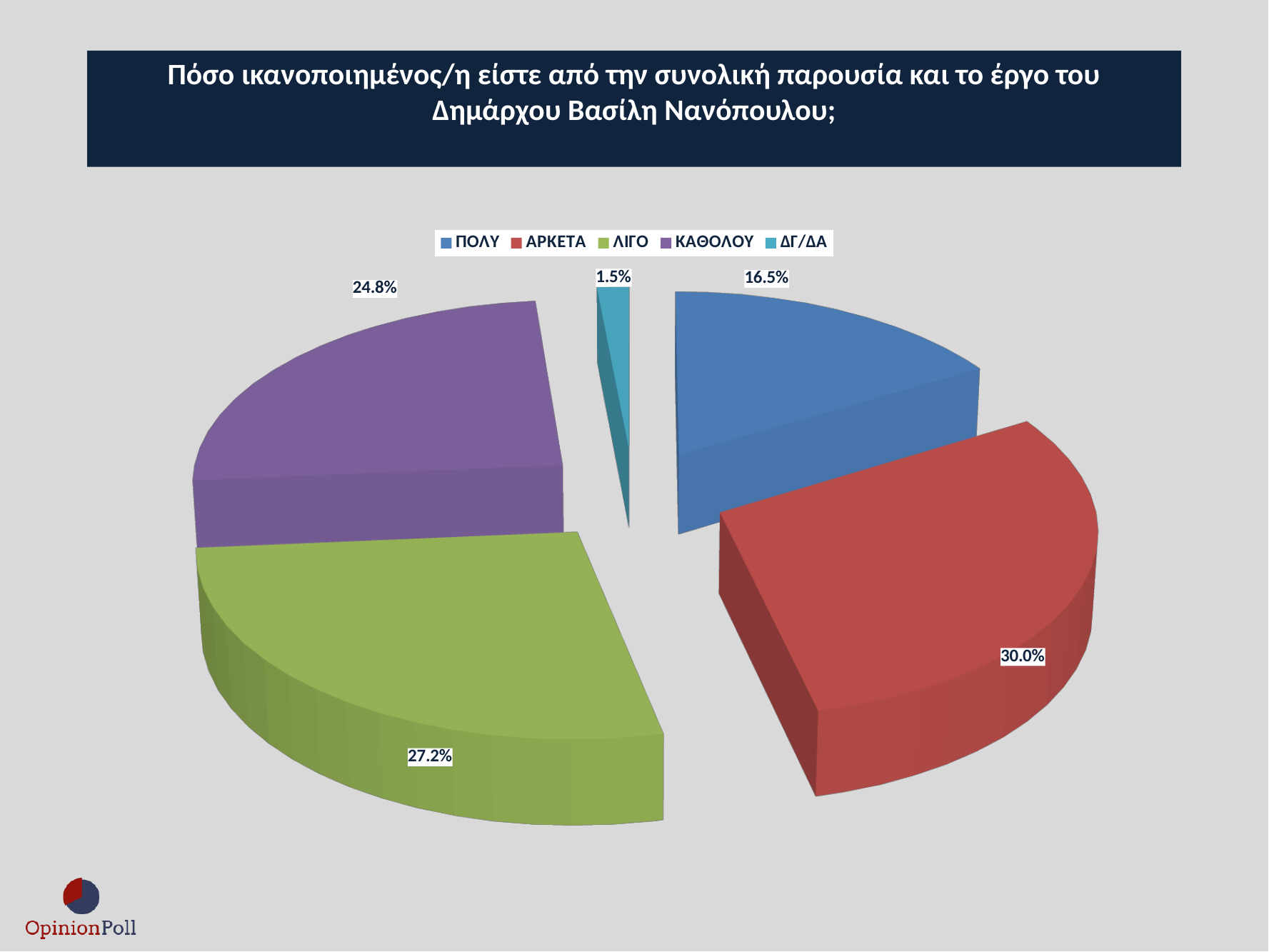
Which response category has the smallest share of the pie? ΔΓ/ΔΑ Which is larger, the share for ΛΙΓΟ or the share for ΚΑΘΟΛΟΥ? ΛΙΓΟ Which response category has the largest share of the pie? ΑΡΚΕΤΑ What percentage of respondents answered ΚΑΘΟΛΟΥ? 24.8% What percentage of respondents answered ΔΓ/ΔΑ? 1.5% What type of chart is shown on the slide? Pie chart What percentage of respondents answered ΛΙΓΟ? 27.2% Which colour represents ΚΑΘΟΛΟΥ in the pie chart? Purple What percentage of respondents answered ΑΡΚΕΤΑ? 30.0% What percentage of respondents answered ΠΟΛΥ? 16.5% What is the difference in percentage points between ΑΡΚΕΤΑ and ΠΟΛΥ? 13.5 How many categories does the legend list? 5